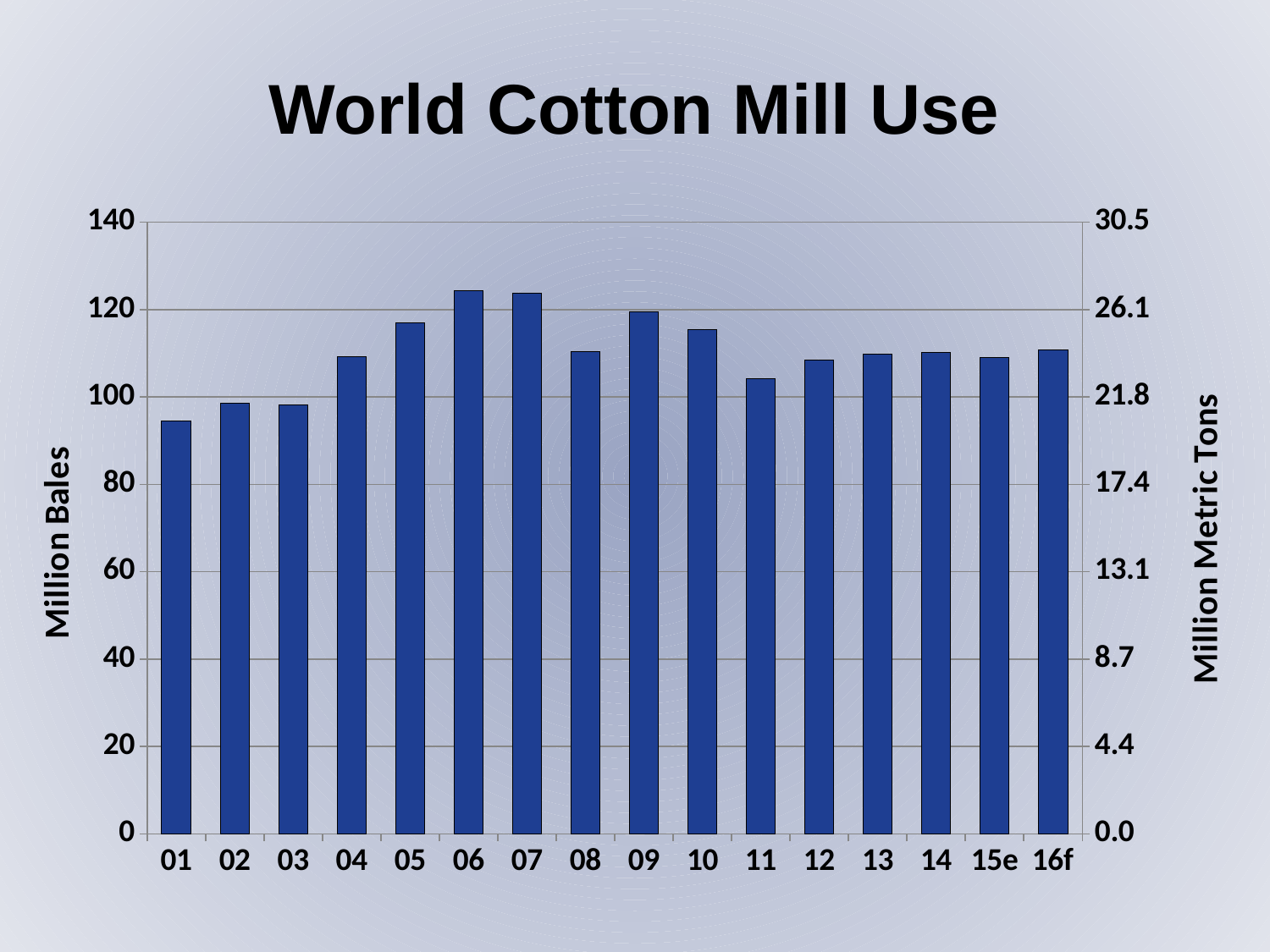
Is the value for 05 greater or less than 120 million bales? less What kind of chart is shown on the slide? bar chart Is the value for 06 greater or less than 120 million bales? greater How many years (bars) are shown on the x axis? 16 Which is larger, the value for 05 or the value for 11? 05 Do the values rise or fall from 01 to 06? rise Is the value for 01 greater or less than 100 million bales? less What is the label of the left vertical axis? Million Bales Which is larger, the value for 09 or the value for 12? 09 Which year has the lowest cotton mill use? 01 What is the title of the chart? World Cotton Mill Use